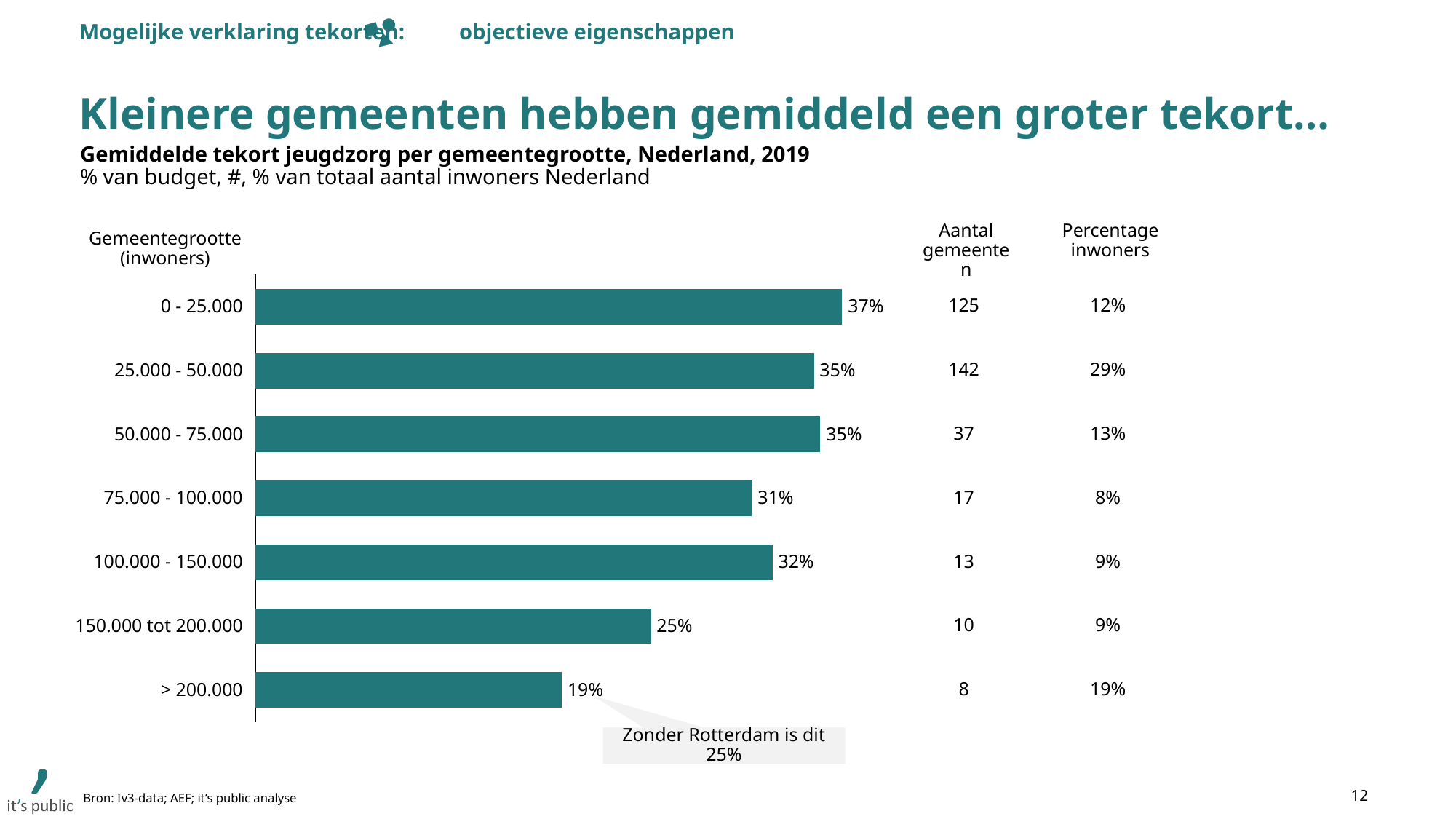
How many municipality size categories are shown in the chart? 7 What type of chart is used on this slide? Bar chart According to the annotation, what would the deficit for > 200.000 be without Rotterdam? 25% What is the value shown for the 150.000 tot 200.000 category? 25% Which has a larger deficit: 75.000 - 100.000 or 100.000 - 150.000? 100.000 - 150.000 What is the difference between the deficit for 0 - 25.000 and the deficit for > 200.000? 18 percentage points What is the title of the chart? Gemiddelde tekort jeugdzorg per gemeentegrootte, Nederland, 2019 Do the deficit values generally rise or fall as municipality size increases from top to bottom? Fall What is the average youth care deficit (% van budget) for municipalities with 0 - 25.000 inhabitants? 37% What is the value shown for the > 200.000 category? 19% Which municipality size category has the highest average deficit? 0 - 25.000 Which municipality size category has the lowest average deficit? > 200.000